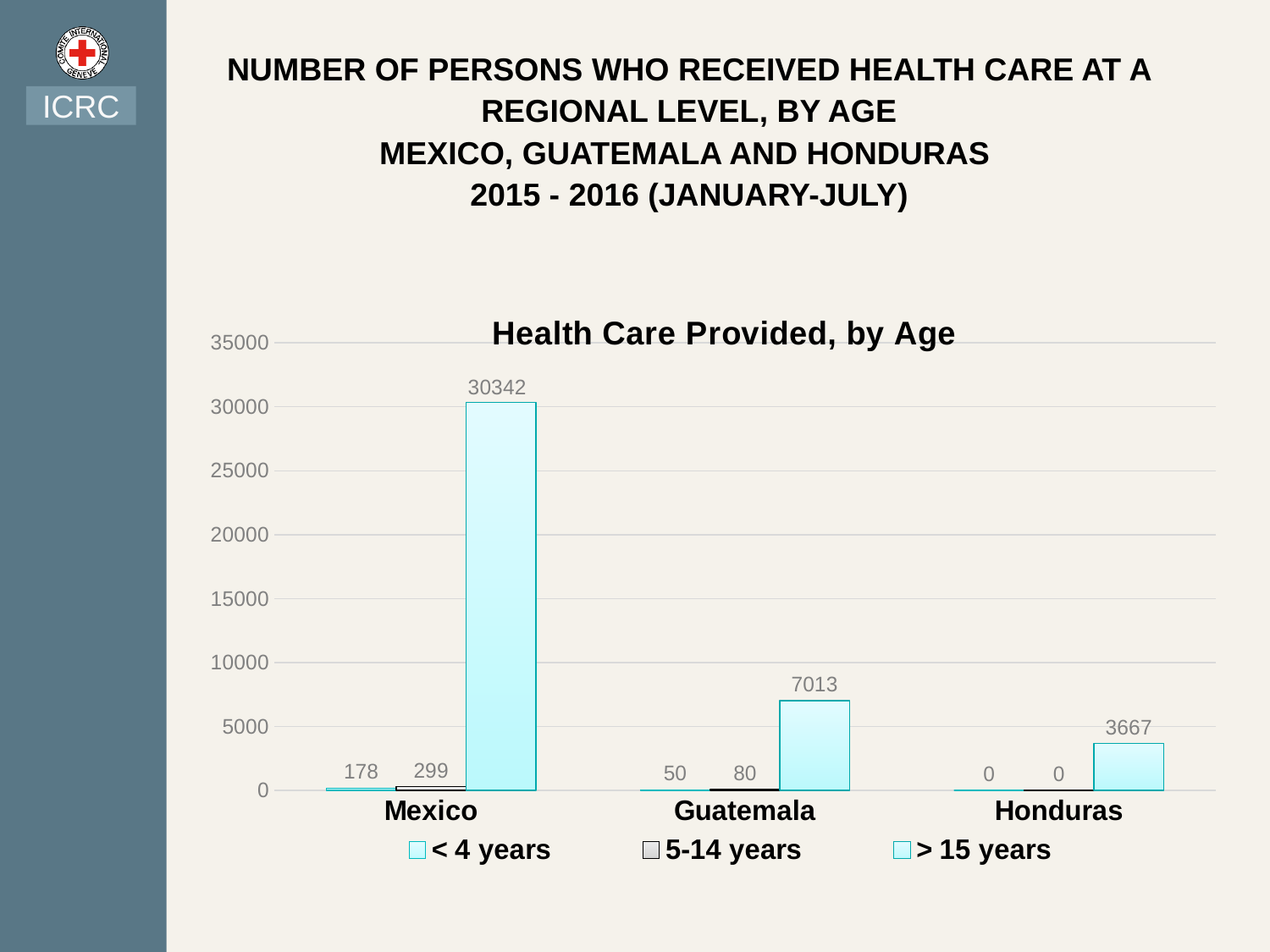
What is the value for the 5-14 years series in Mexico? 299 What kind of chart is shown? Bar chart What is the value for the < 4 years series in Guatemala? 50 What is the value for the 5-14 years series in Honduras? 0 How many series does the legend list? 3 Which country has the lowest value for the < 4 years series? Honduras Which is larger: the 5-14 years value for Mexico or the 5-14 years value for Guatemala? Mexico Which country has the highest value for the > 15 years series? Mexico What is the title of the chart? Health Care Provided, by Age What is the value for the > 15 years series in Mexico? 30342 How many countries are shown on the x axis? 3 What is the difference between the > 15 years values for Guatemala and Honduras? 3346